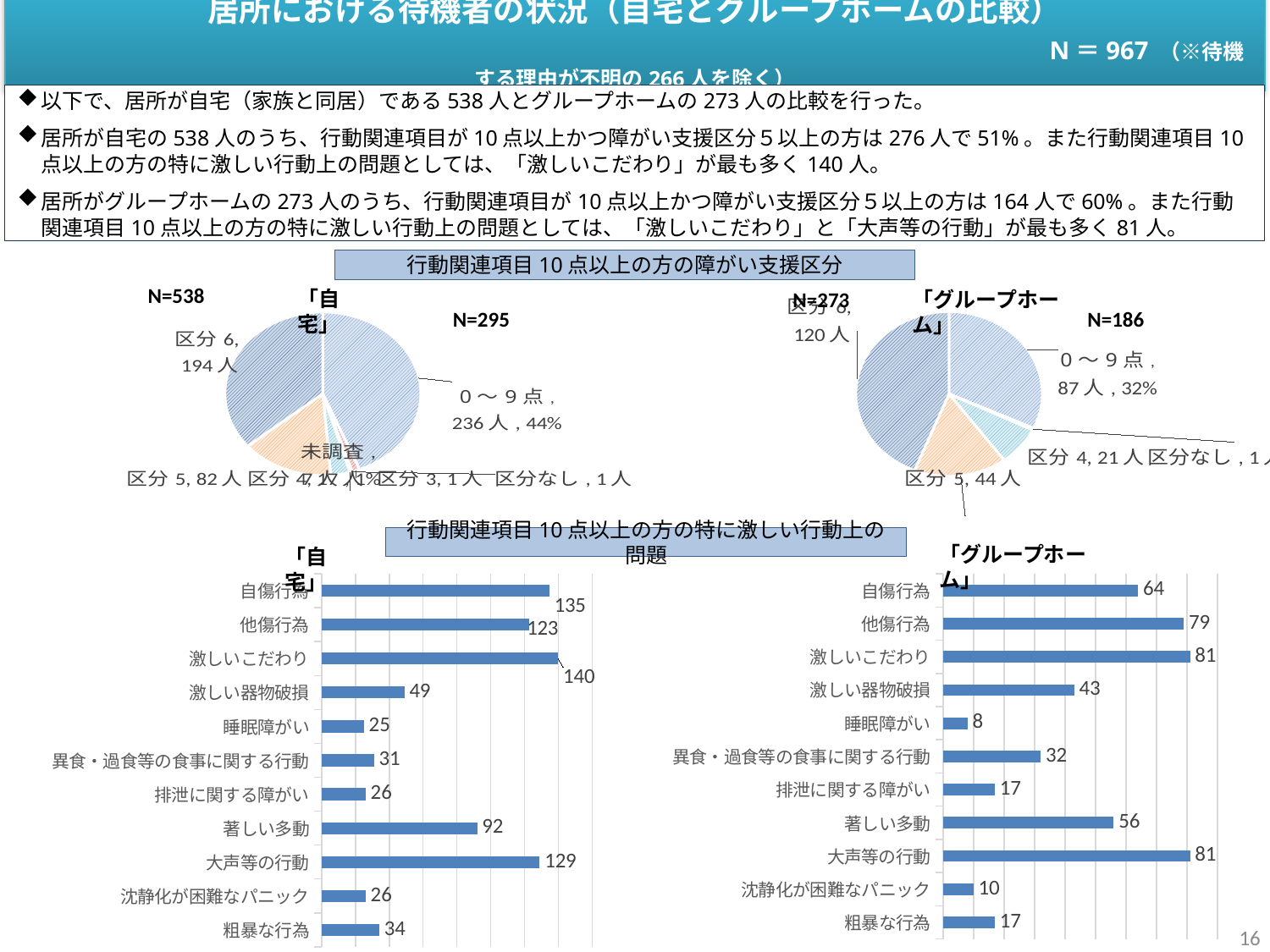
In the bottom-left bar chart (「自宅」, 特に激しい行動上の問題), what is the value for 激しいこだわり? 140 In the top-right pie chart (「グループホーム」), what share of the pie is the 0～9点 slice? 32% In the bottom-left bar chart (「自宅」), which category has the lowest value? 睡眠障がい In the bottom-right bar chart (「グループホーム」), what is the difference between 激しいこだわり and 激しい器物破損? 38 In the top-left pie chart (「自宅」, 障がい支援区分), how many people are in the 0～9点 slice? 236人 In the bottom-right bar chart (「グループホーム」), which category has the lowest value? 睡眠障がい What type of chart is used for the 特に激しい行動上の問題 section at the bottom of the slide? Bar chart In the bottom-left bar chart (「自宅」), how many categories are shown? 11 In the top-right pie chart (「グループホーム」), how many people are in the 区分5 slice? 44人 In the bottom-left bar chart (「自宅」), what is the difference between 自傷行為 and 他傷行為? 12 In the bottom-right bar chart (「グループホーム」), what is the value for 著しい多動? 56 In the bottom-right bar chart (「グループホーム」), which is larger, 他傷行為 or 自傷行為? 他傷行為